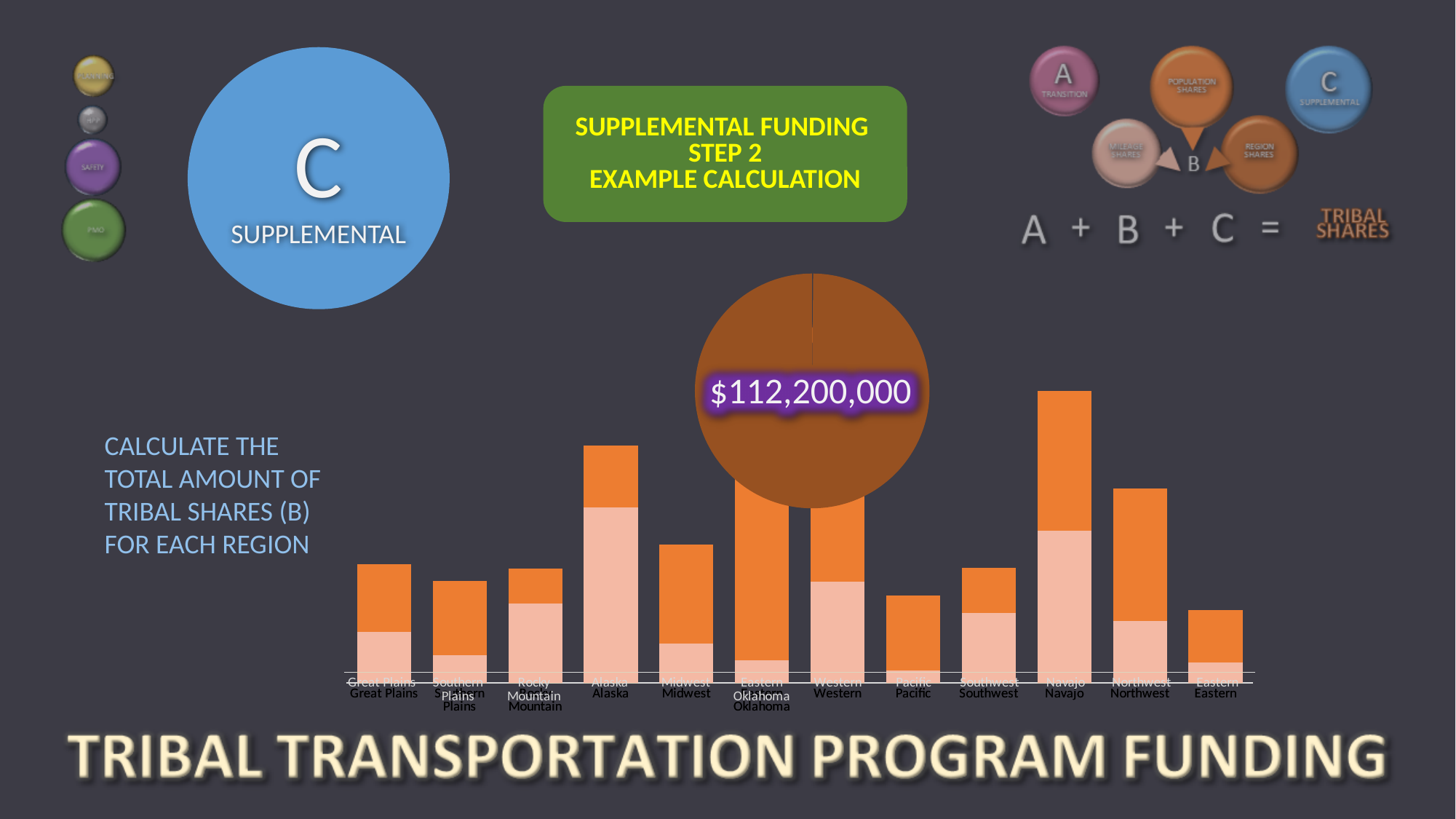
In the bar chart, which region has the larger light-coloured (bottom) segment, Alaska or Navajo? Alaska How many coloured segments make up each bar in the bar chart? 2 How many regions are shown on the x axis of the bar chart? 12 In the bar chart, which bar is taller, Navajo or Alaska? Navajo In the bar chart, which bar is taller, Alaska or Midwest? Alaska What value is labelled on the circular (pie) chart above the bar chart? $112,200,000 Which region has the shortest bar in the bar chart? Eastern What kind of chart shows the regions such as Great Plains, Alaska and Navajo? bar chart What is the name of the region whose bar is immediately to the right of Alaska in the bar chart? Midwest